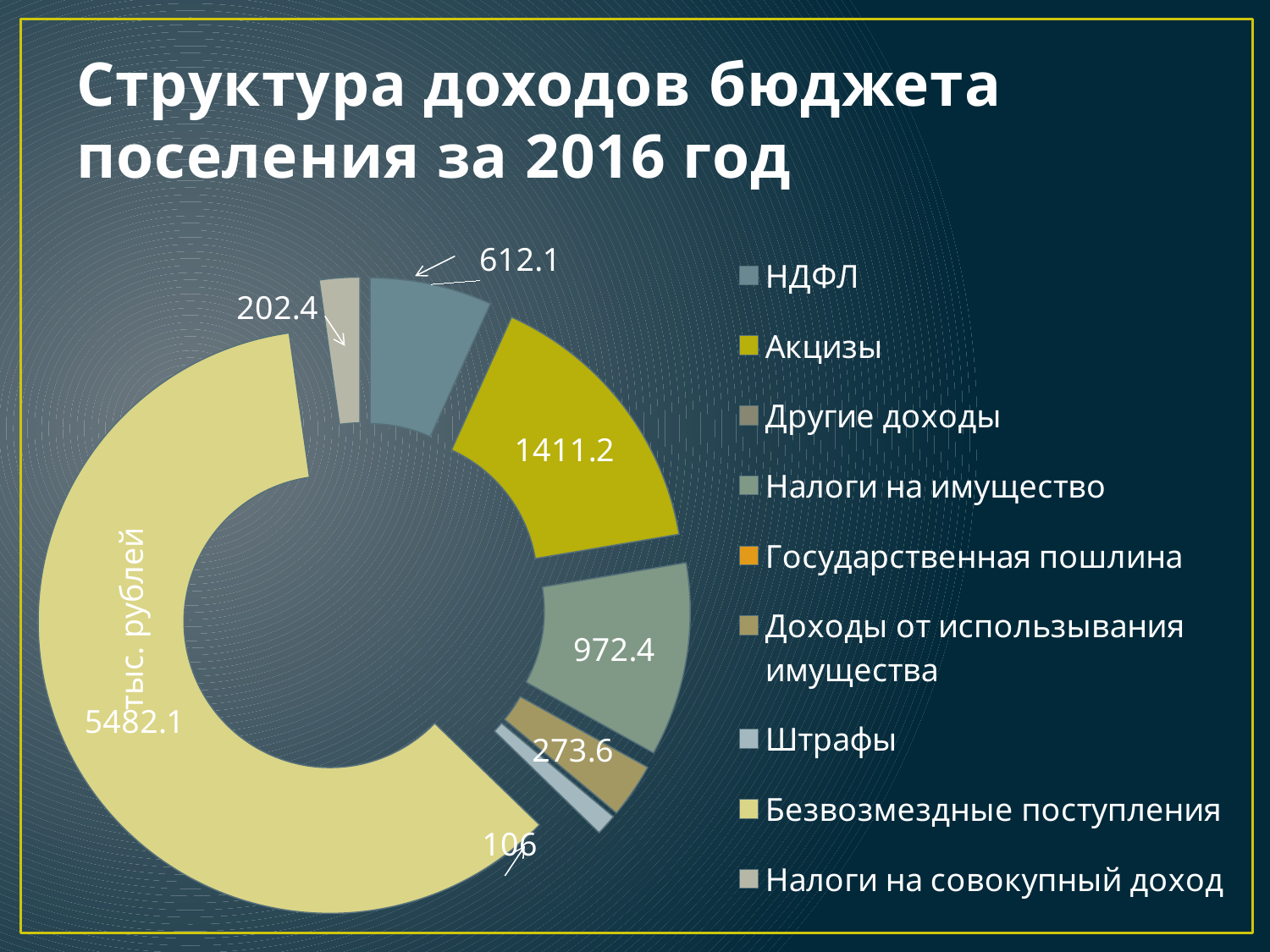
What is the value shown for Налоги на имущество? 972.4 What is the difference between the values for Акцизы and Налоги на имущество? 438.8 Which is larger, the value for НДФЛ or the value for Налоги на совокупный доход? НДФЛ What is the value shown for Налоги на совокупный доход? 202.4 Among the slices with data labels, which category has the smallest value? Штрафы What is the value shown for НДФЛ? 612.1 What is the value shown for Безвозмездные поступления? 5482.1 How many entries does the legend list? 9 What type of chart is shown on the slide? Doughnut (pie) chart What is the value shown for Доходы от использывания имущества? 273.6 What is the value shown for Акцизы? 1411.2 Which category has the largest slice in the chart? Безвозмездные поступления